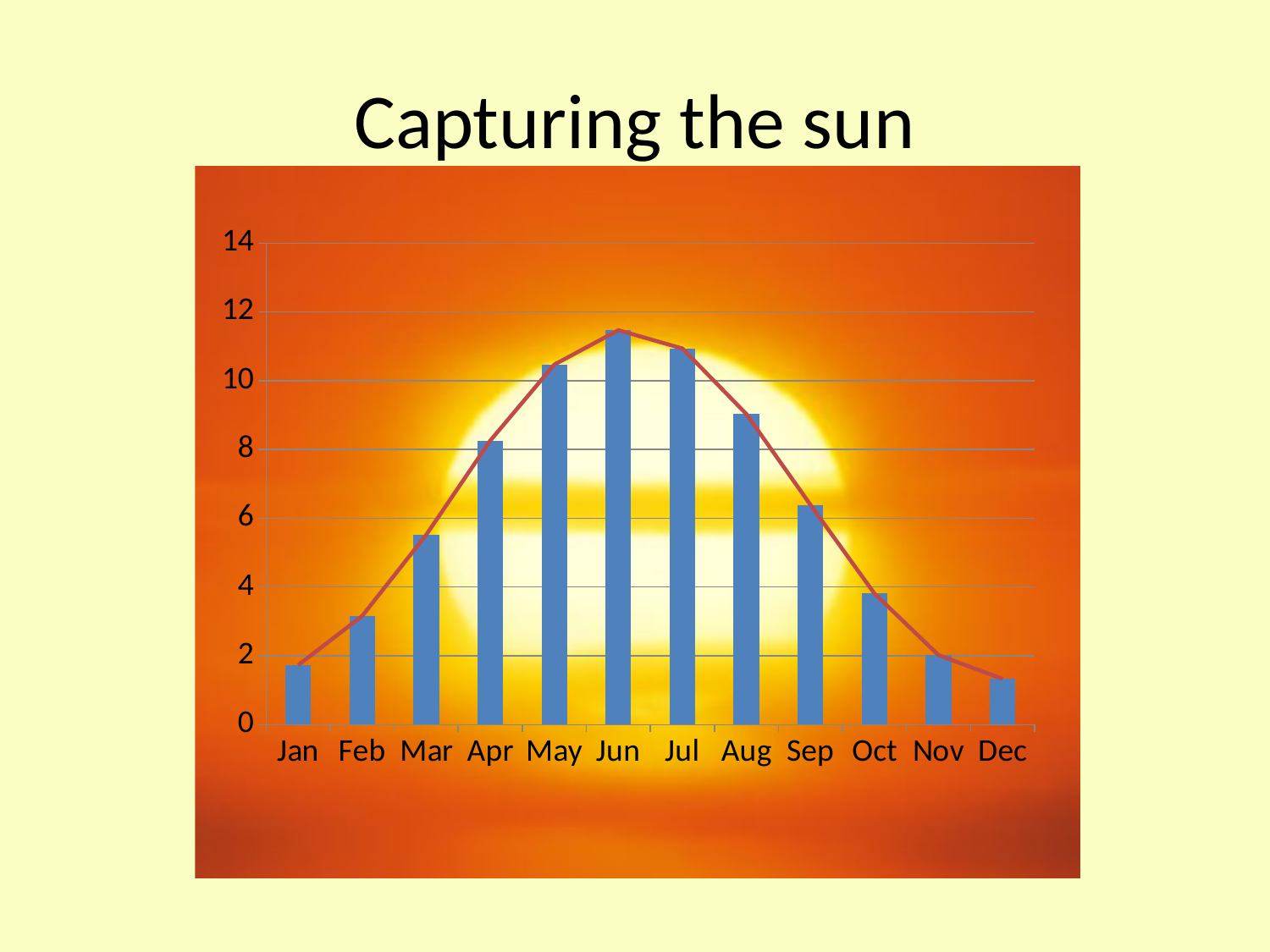
Is the value for Oct greater or less than 2? greater Is the value for Jan greater or less than 2? less What kind of chart is shown on the slide? combination bar and line chart Is the value for May greater or less than 10? greater What is the title of the slide containing the chart? Capturing the sun Do the values rise or fall from Jan to Jun? rise Which month has the larger value, Jul or Aug? Jul Which month has the lowest bar? Dec How many months are shown on the x axis of the chart? 12 Which month has the highest bar? Jun